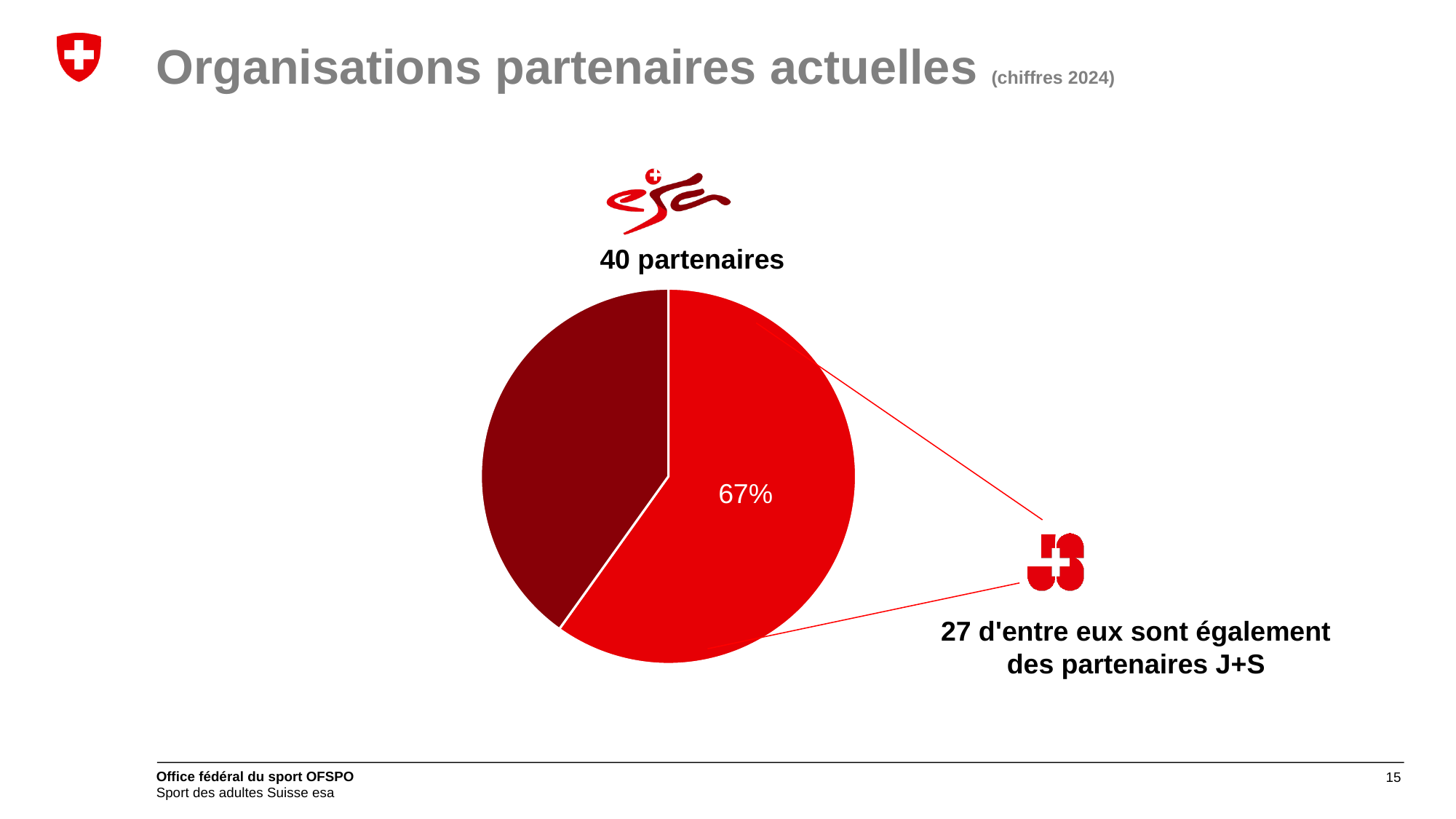
Is the bright red slice of the pie chart more or less than half of the pie? more What percentage is printed on the bright red slice of the pie chart? 67% What kind of chart is shown on the slide? pie chart How many partners in total does the slide state above the pie chart? 40 partenaires Which slice of the pie chart is larger, the bright red one or the dark red one? the bright red one According to the slide, how many of the partners are also J+S partners? 27 What is the title of the slide containing the pie chart? Organisations partenaires actuelles (chiffres 2024) What share of the pie do the partners that are also J+S partners represent? 67% How many slices does the pie chart have? 2 How many of the 40 partners are not J+S partners? 13 Which year do the figures in the pie chart refer to, according to the title? 2024